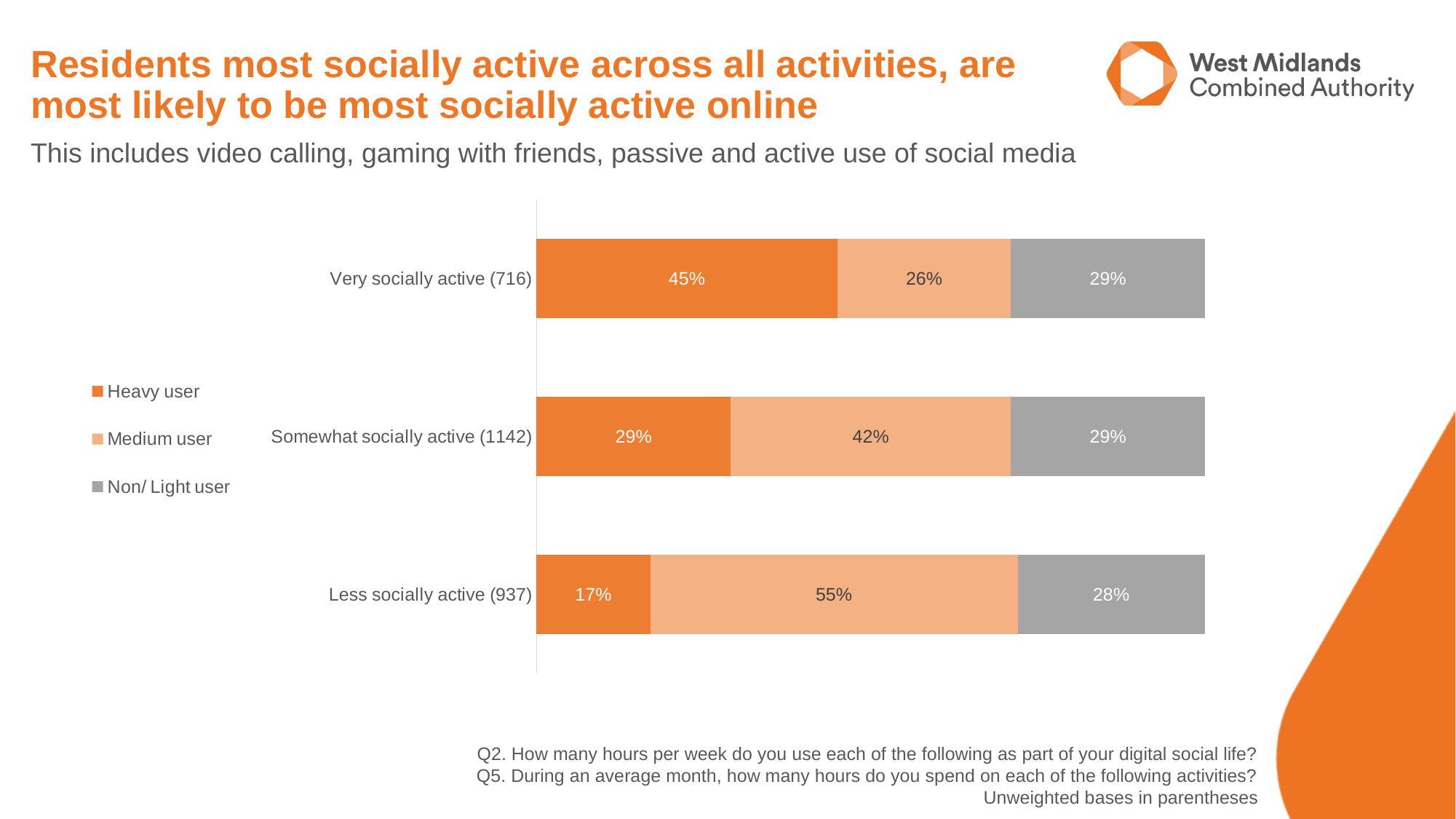
What percentage of the Less socially active group are Medium users? 55% What is the unweighted base for the Somewhat socially active group? 1142 What is the difference in the Heavy user share between the Very socially active and Less socially active groups? 28 percentage points What percentage of the Very socially active group are Heavy users? 45% What is the total of the stacked bar for the Less socially active group? 100% How many series does the legend list? 3 Which group has the lowest share of Heavy users? Less socially active (937) Which is larger: the Medium user share for Somewhat socially active or for Very socially active? Somewhat socially active What percentage of the Somewhat socially active group are Non/ Light users? 29% Which group has the highest share of Heavy users? Very socially active (716) What kind of chart is shown on the slide? Stacked bar chart How many groups (categories) are shown on the chart? 3